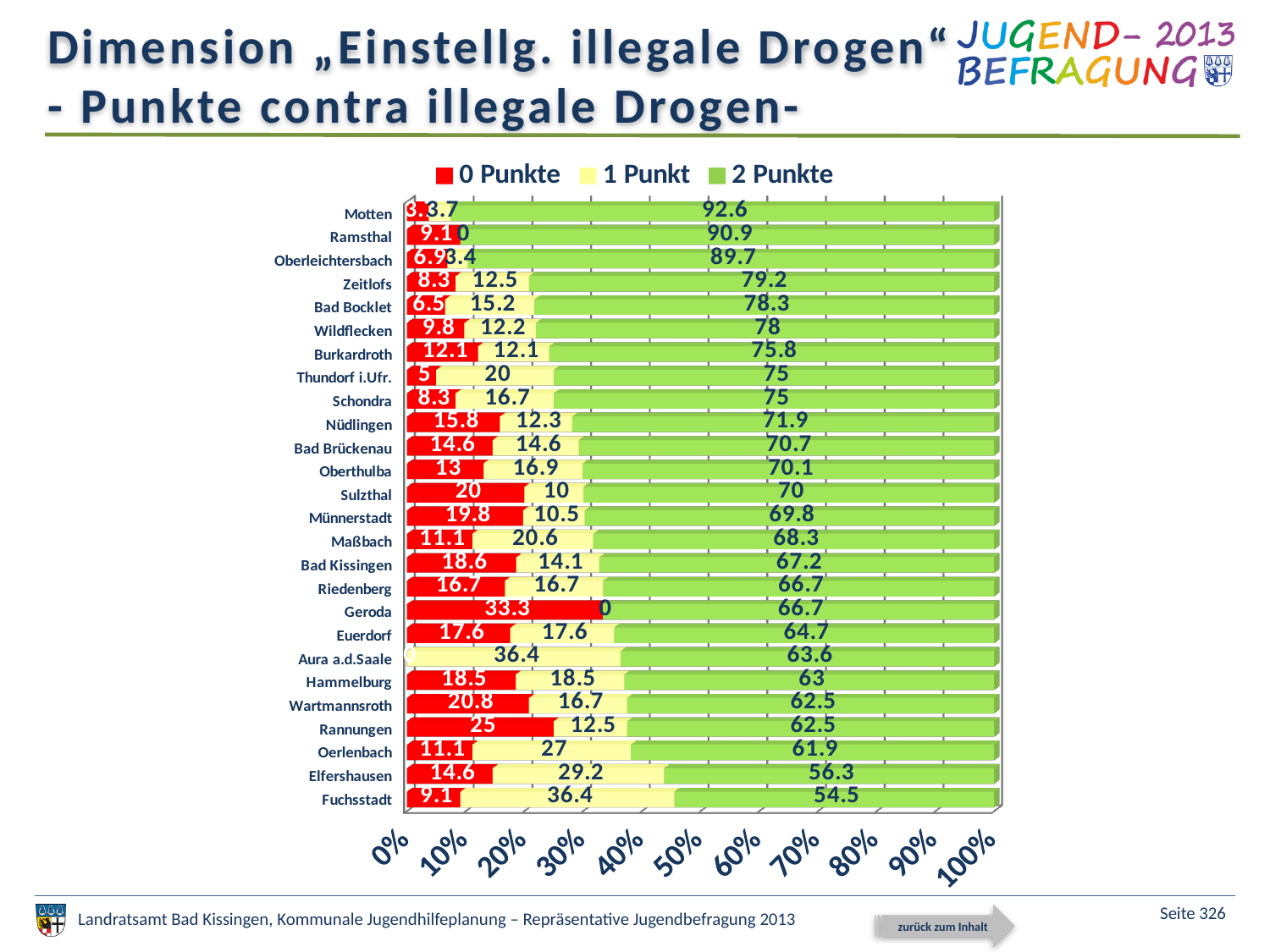
What is the "1 Punkt" value for Elfershausen? 29.2 Which municipality has the highest value for "0 Punkte"? Geroda Which is larger, the "0 Punkte" value for Rannungen or for Wartmannsroth? Rannungen What is the difference between the "2 Punkte" values of Ramsthal and Fuchsstadt? 36.4 How many series does the legend list? 3 What is the "2 Punkte" value for Zeitlofs? 79.2 Which colour represents the "2 Punkte" series in the legend? Green Which municipality has the lowest value for "2 Punkte"? Fuchsstadt What is the "0 Punkte" value for Geroda? 33.3 Which municipality has the highest value for "2 Punkte"? Motten How many municipalities (categories) are shown in the chart? 26 What kind of chart is shown on the slide? Stacked bar chart